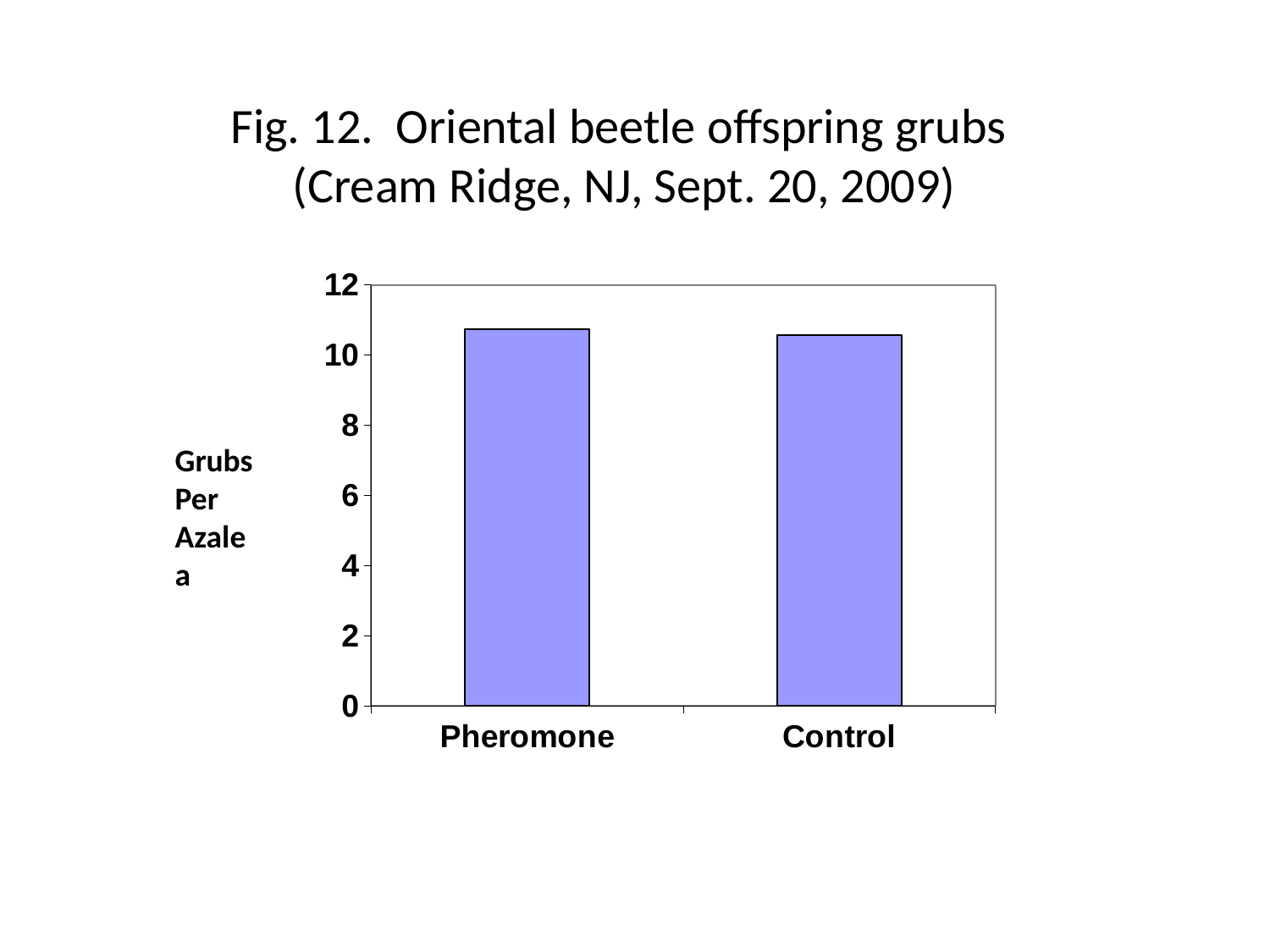
What are the two categories shown on the x axis? Pheromone and Control What is the highest tick value shown on the vertical axis? 12 How many categories are plotted on the x axis? 2 Is the value for Control greater or less than 8? greater What is the label on the vertical axis of the chart? Grubs Per Azalea Is the value for Control greater or less than 10? greater What is the title of the chart on the slide? Fig. 12. Oriental beetle offspring grubs (Cream Ridge, NJ, Sept. 20, 2009) Is the value for Pheromone greater or less than 10? greater What kind of chart is shown on the slide? bar chart